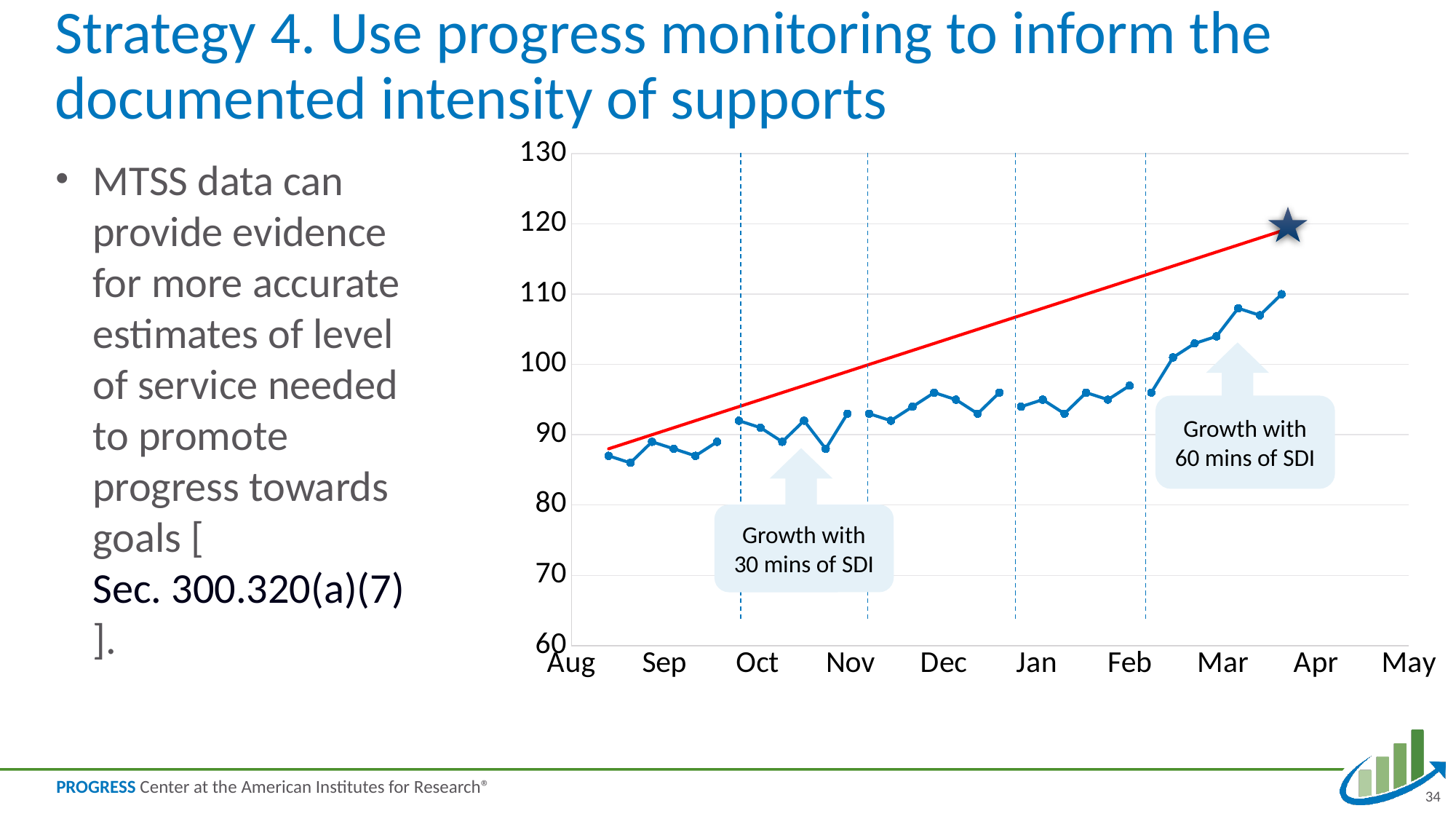
What is the lowest value shown on the y axis of the chart? 60 What is the first month label on the x axis of the chart? Aug Is the blue line's value at the Nov marker greater or less than 100? less Does the red line rise or fall from Aug to Apr? rise Does the blue line generally rise or fall from Feb to Apr? rise How many month labels are shown along the x axis of the chart? 10 Is the first plotted value of the blue line (after Aug) greater or less than 90? less What kind of chart is shown on the slide? line chart Is the blue line's value at the Feb marker greater or less than 90? greater Which is larger: the blue line's value just before Apr or its value at the Sep marker? the value just before Apr What is the last month label on the x axis of the chart? May